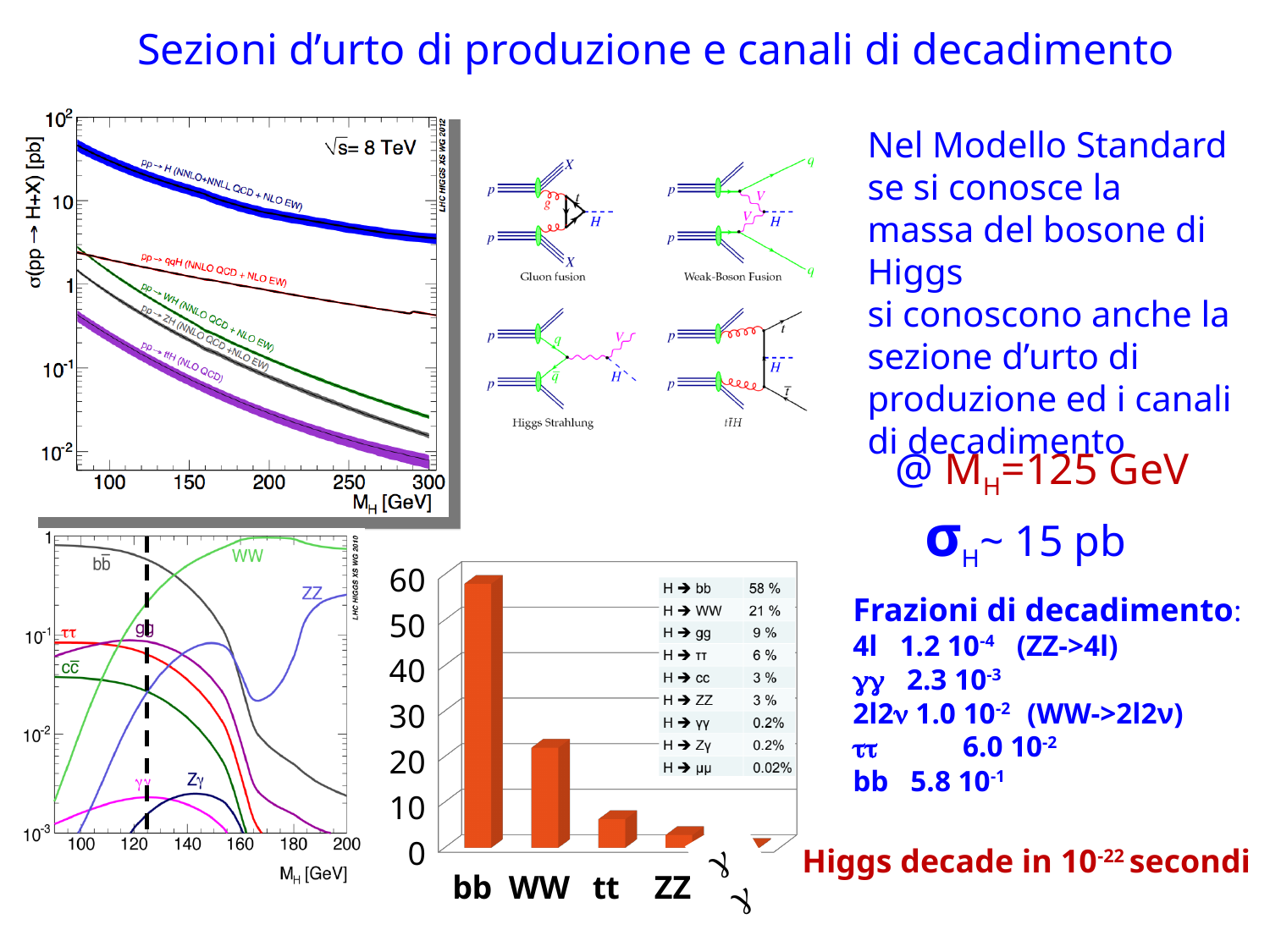
What centre-of-mass energy is stated in the top-left line chart? √s = 8 TeV In the bar chart at the bottom centre, which category has the tallest bar? bb In the bar chart at the bottom centre, is the bar for bb greater or less than 50? greater In the bar chart at the bottom centre, is the bar for WW greater or less than 30? less In the top-left line chart of σ(pp → H+X) versus M_H, do the cross sections rise or fall as M_H increases? fall What kind of chart is the chart at the bottom centre of the slide with categories bb, WW, tt, ZZ? bar chart In the bar chart at the bottom centre, which bar is taller, WW or ZZ? WW In the bar chart at the bottom centre, which category has the shortest bar? γγ According to the table inset in the bar chart at the bottom centre, what is the value for H → bb? 58 % According to the table inset in the bar chart at the bottom centre, what is the value for H → WW? 21 % According to the table inset in the bar chart at the bottom centre, what is the value for H → μμ? 0.02% Using the table inset in the bar chart at the bottom centre, what is the difference between the H → bb and H → WW values? 37 %